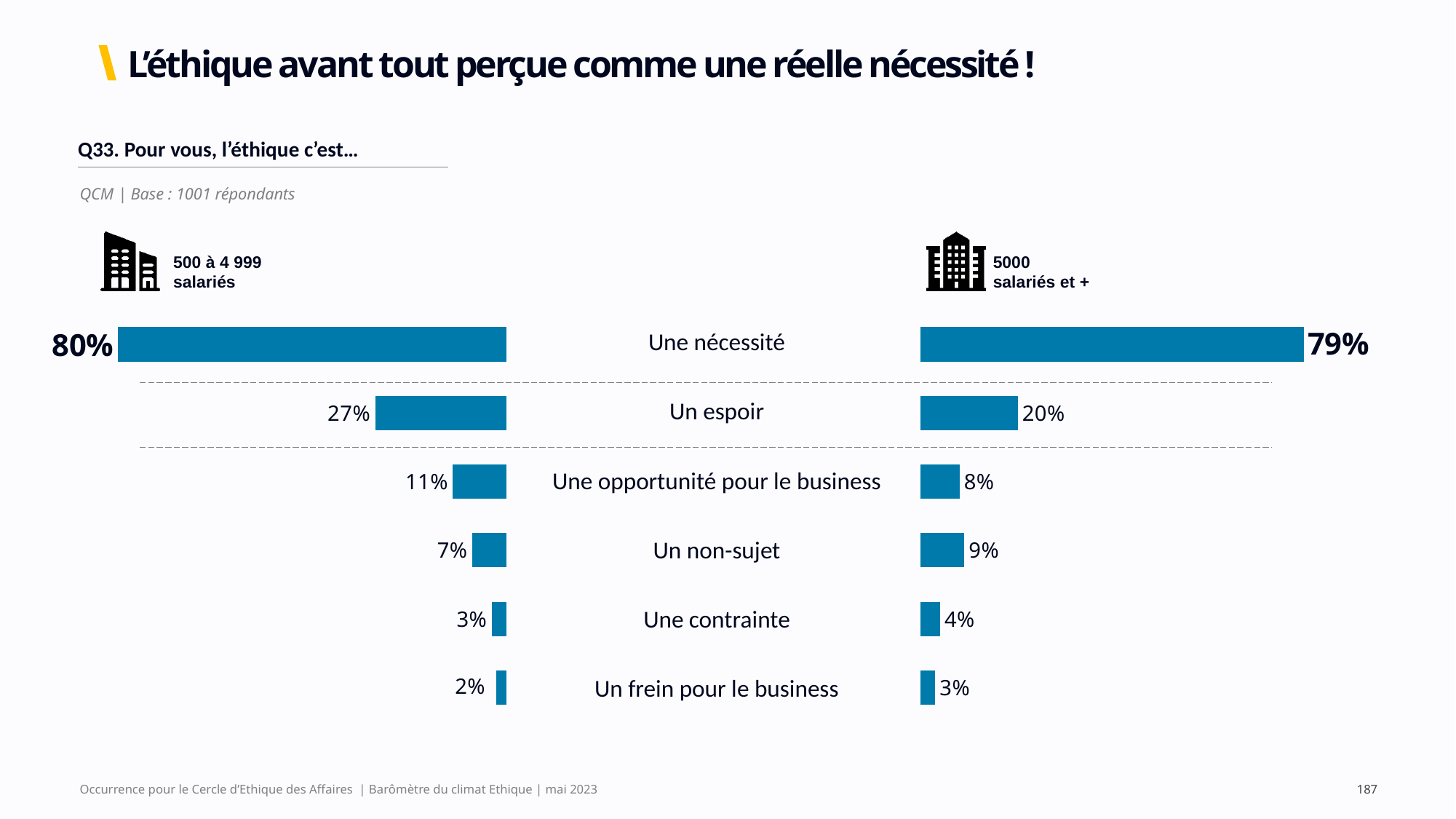
In the chart for 5000 salariés et +, what is the value for Un non-sujet? 9% Which is larger: the value for Un non-sujet in the 500 à 4 999 salariés chart or in the 5000 salariés et + chart? 5000 salariés et + What kind of chart is used for the 5000 salariés et + data? Bar chart In the chart for 500 à 4 999 salariés, what is the difference between Une nécessité and Un espoir? 53 percentage points In the chart for 500 à 4 999 salariés, what is the value for Une nécessité? 80% In the chart for 5000 salariés et +, which category has the highest value? Une nécessité What is the difference between the values for Un espoir in the 500 à 4 999 salariés chart and the 5000 salariés et + chart? 7 percentage points What is the survey question shown above the charts? Q33. Pour vous, l'éthique c'est… In the chart for 5000 salariés et +, what is the value for Un espoir? 20% In the chart for 500 à 4 999 salariés, what is the value for Une opportunité pour le business? 11% In the chart for 500 à 4 999 salariés, which category has the lowest value? Un frein pour le business How many categories are shown in the chart for 500 à 4 999 salariés? 6